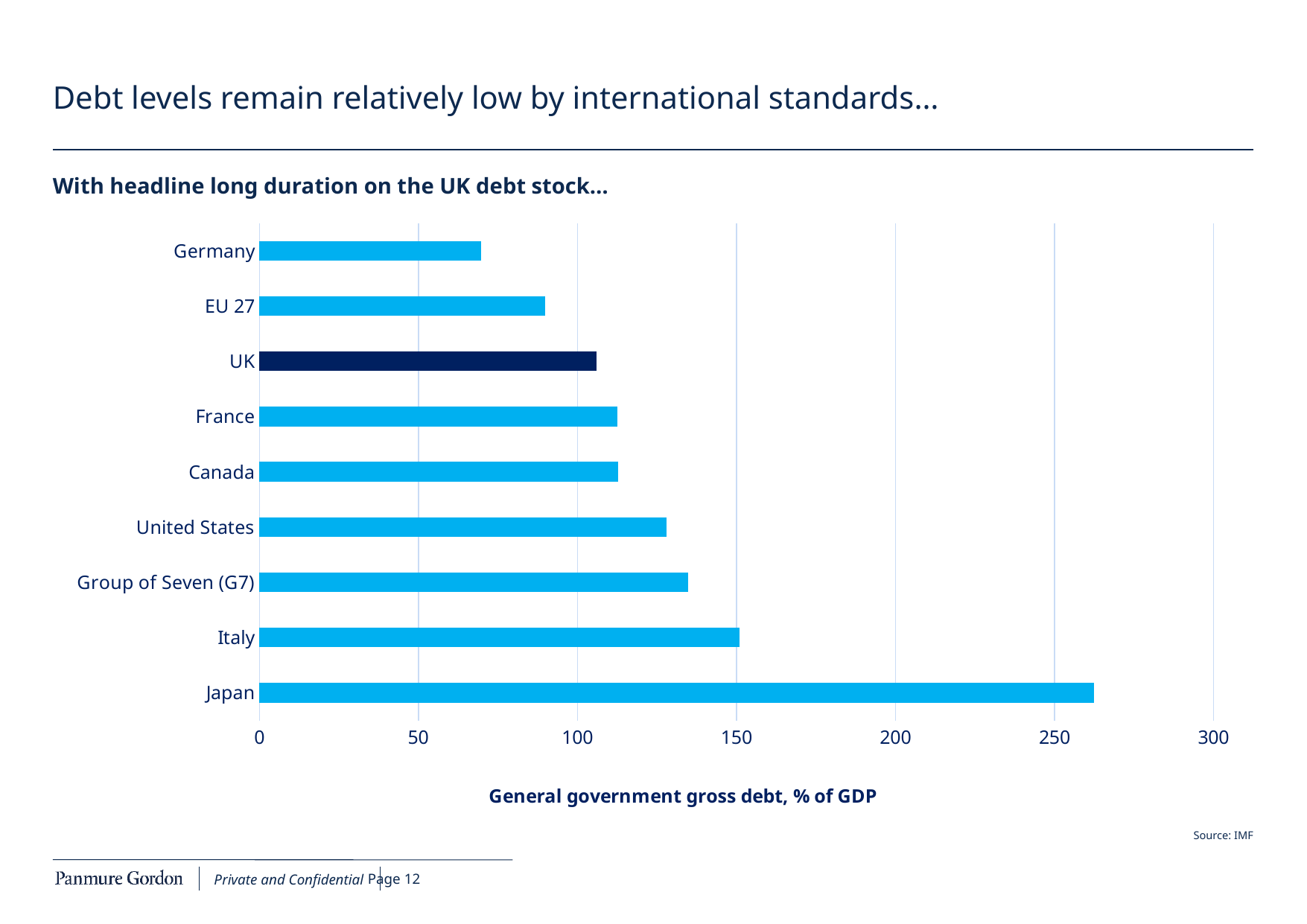
Is the value for UK greater or less than 100? greater Is the value for Group of Seven (G7) greater or less than 150? less Which country or group has the highest general government gross debt as % of GDP? Japan Which has the larger value, Italy or United States? Italy How many countries or groups are plotted in the chart? 9 What kind of chart is shown on the slide? bar chart Is the value for Germany greater or less than 100? less What is the title of the horizontal axis? General government gross debt, % of GDP Which country or group has the lowest general government gross debt as % of GDP? Germany Which has the larger value, UK or Germany? UK